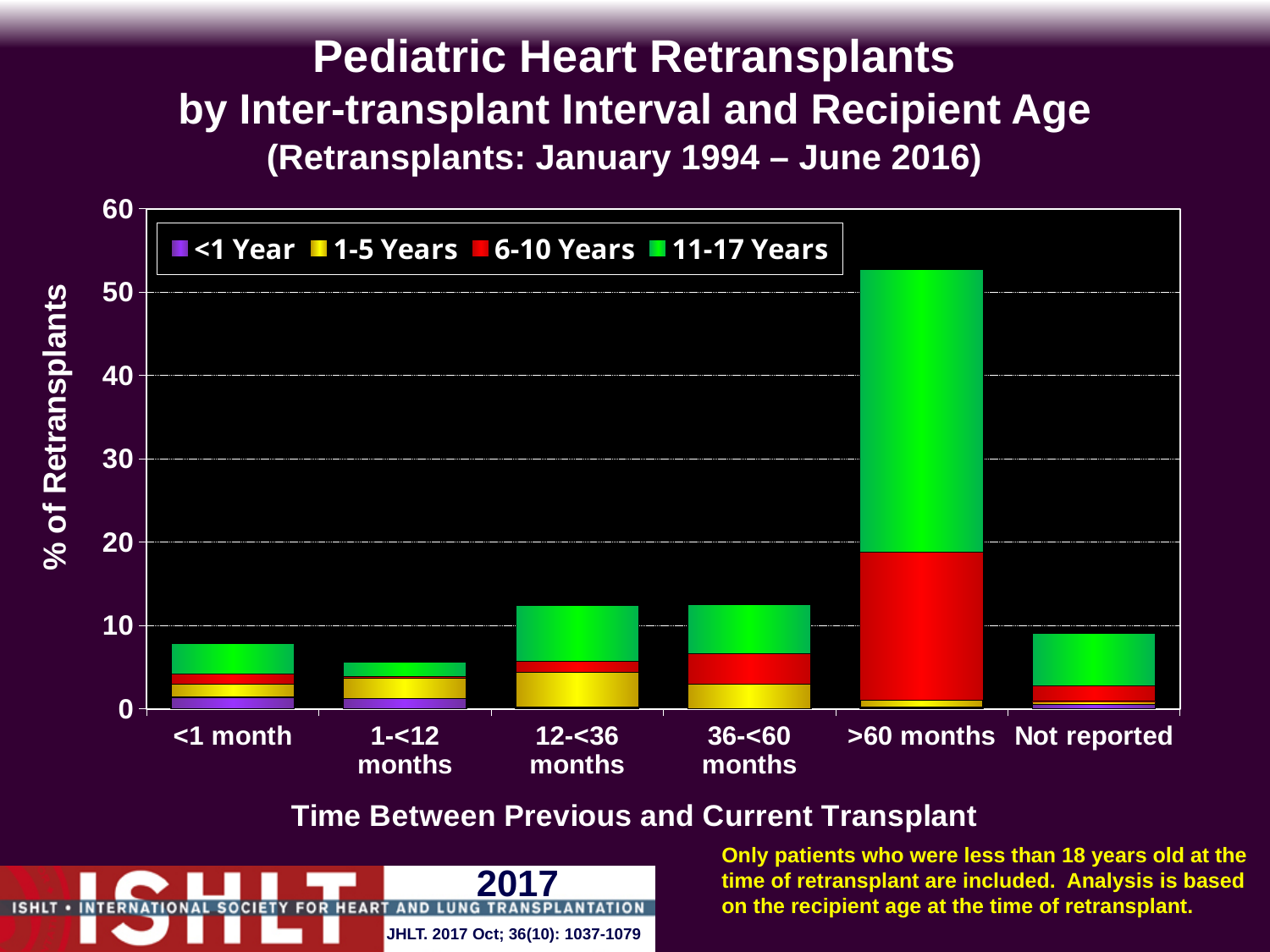
How many recipient age groups does the legend list? 4 Which has a larger total percentage of retransplants, >60 months or Not reported? >60 months Is the total value for >60 months greater or less than 40? greater How many inter-transplant interval categories are shown on the x axis? 6 Which inter-transplant interval has the highest total percentage of retransplants? >60 months Which has a larger total percentage of retransplants, 12-<36 months or 1-<12 months? 12-<36 months Is the total value for <1 month greater or less than 10? less Which recipient age group is shown in green in the legend? 11-17 Years Which inter-transplant interval has the lowest total percentage of retransplants? 1-<12 months Is the total value for 12-<36 months greater or less than 20? less What is the label of the y axis? % of Retransplants What kind of chart is shown on the slide? Stacked bar chart